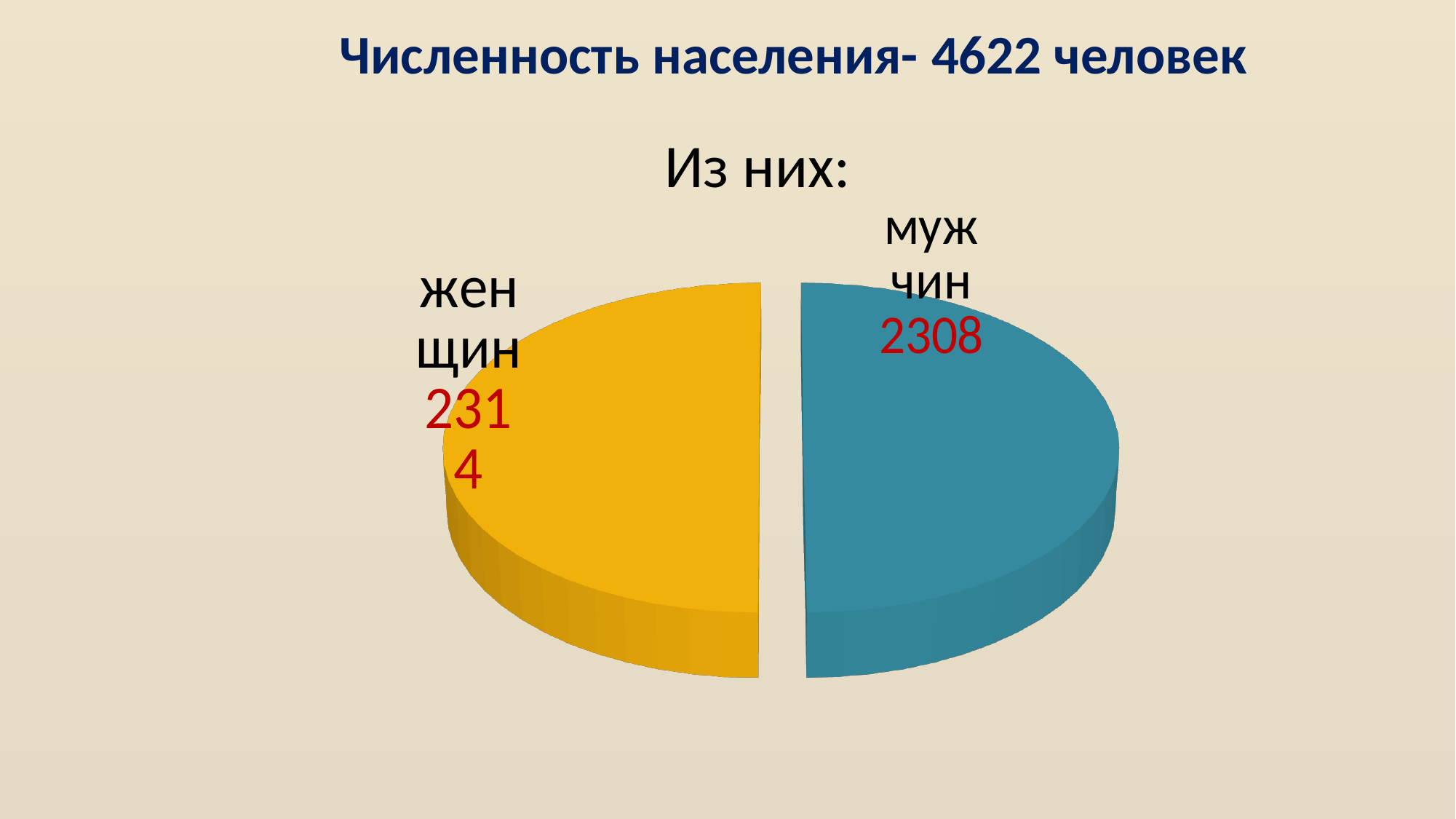
Which category has the smallest value in the pie chart? мужчин What kind of chart is shown on the slide? pie chart How many slices does the pie chart have? 2 What is the total of the two values shown in the pie chart? 4622 Which category has the larger value in the pie chart, женщин or мужчин? женщин What is the difference between the values for женщин and мужчин? 6 What is the value shown for мужчин in the pie chart? 2308 What colour is the slice for мужчин? blue What is the title of the chart? Из них: What is the value shown for женщин in the pie chart? 2314